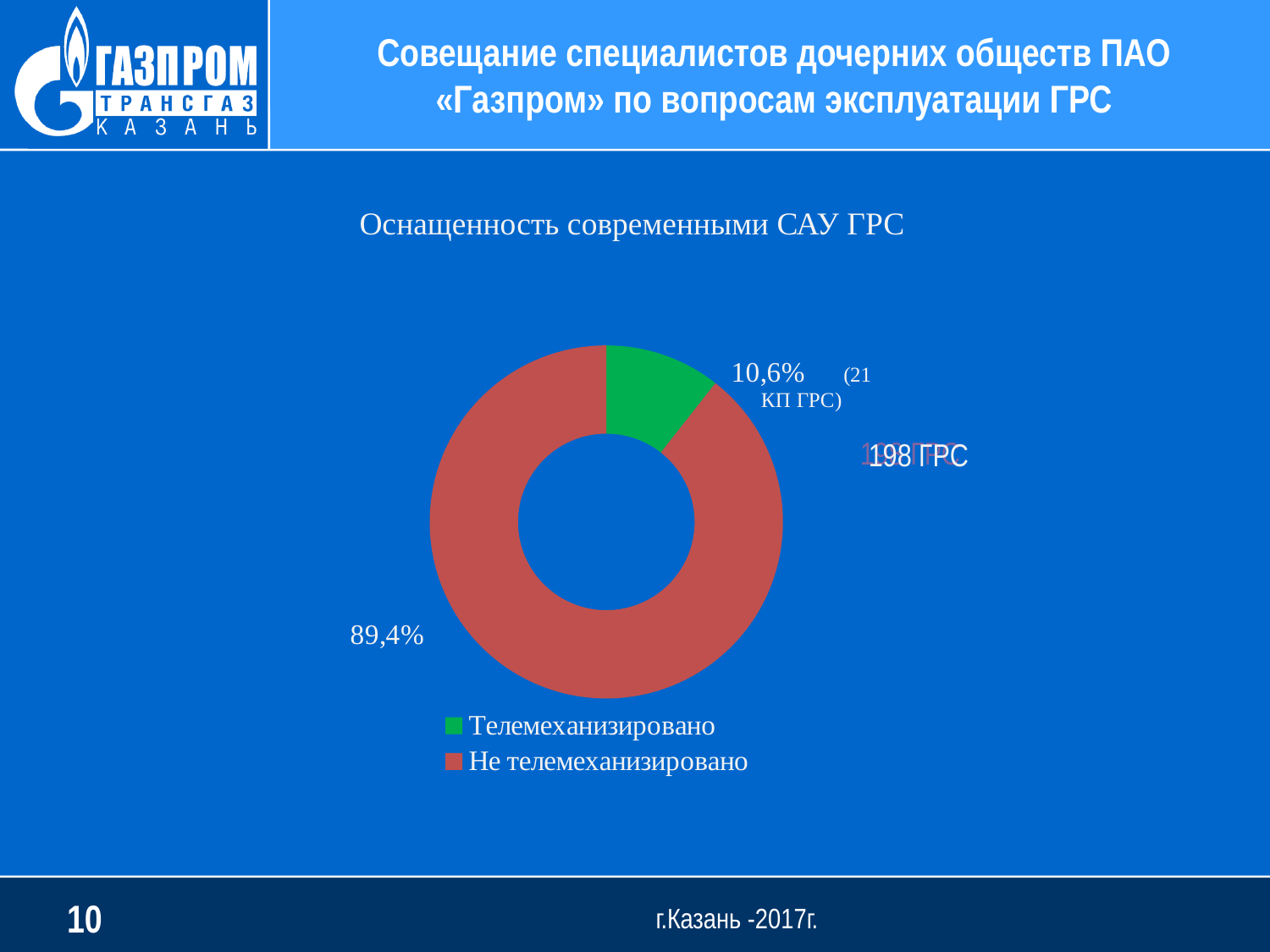
What kind of chart is shown on the slide? doughnut (pie) chart What colour represents "Телемеханизировано" in the chart? green What percentage is shown for the "Телемеханизировано" slice? 10,6% How many КП ГРС does the label next to the 10,6% slice mention? 21 What percentage is shown for the "Не телемеханизировано" slice? 89,4% What is the difference in percentage points between the "Не телемеханизировано" and "Телемеханизировано" slices? 78,8 How many slices does the chart have? 2 What is the title of the chart on the slide? Оснащенность современными САУ ГРС How many entries does the chart legend list? 2 Which slice of the chart is the largest? Не телемеханизировано Which slice of the chart is the smallest? Телемеханизировано Which is larger: the "Телемеханизировано" slice or the "Не телемеханизировано" slice? Не телемеханизировано